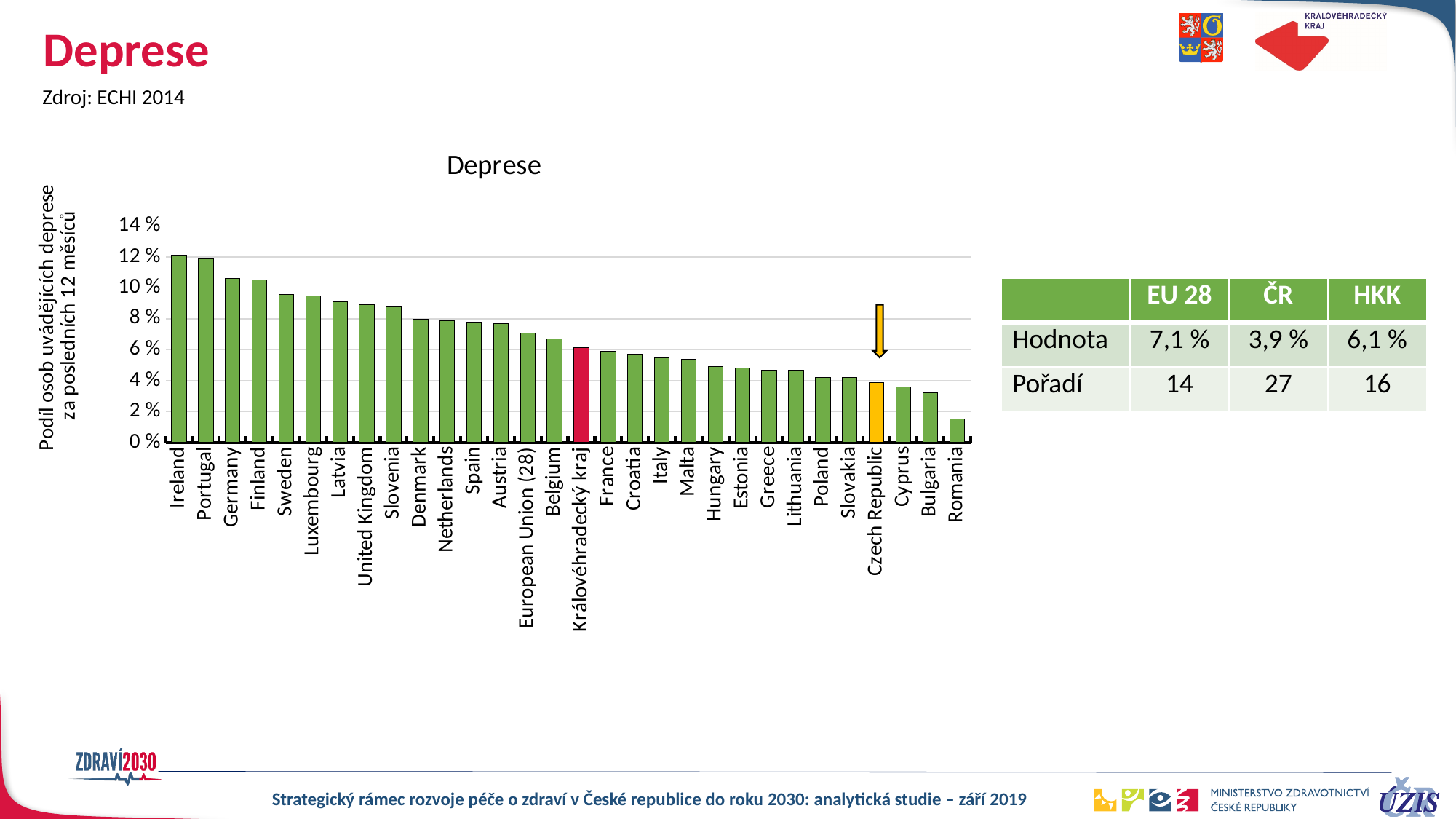
Do the values rise or fall from left to right along the x axis? fall Is the value for Romania greater or less than 2 %? less Which country has the lowest share of people reporting depression in the chart? Romania According to the table, what is the value for ČR (Czech Republic)? 3,9 % Is the value for Ireland greater or less than 10 %? greater Which has the larger value, Germany or Sweden? Germany According to the table, what is the value for HKK (Královéhradecký kraj)? 6,1 % What kind of chart is shown on the slide? bar chart What is the difference between the EU 28 value and the HKK value in the table? 1,0 % Which country has the highest share of people reporting depression in the chart? Ireland How many categories (bars) are plotted in the chart? 30 According to the table, what is the value for EU 28? 7,1 %